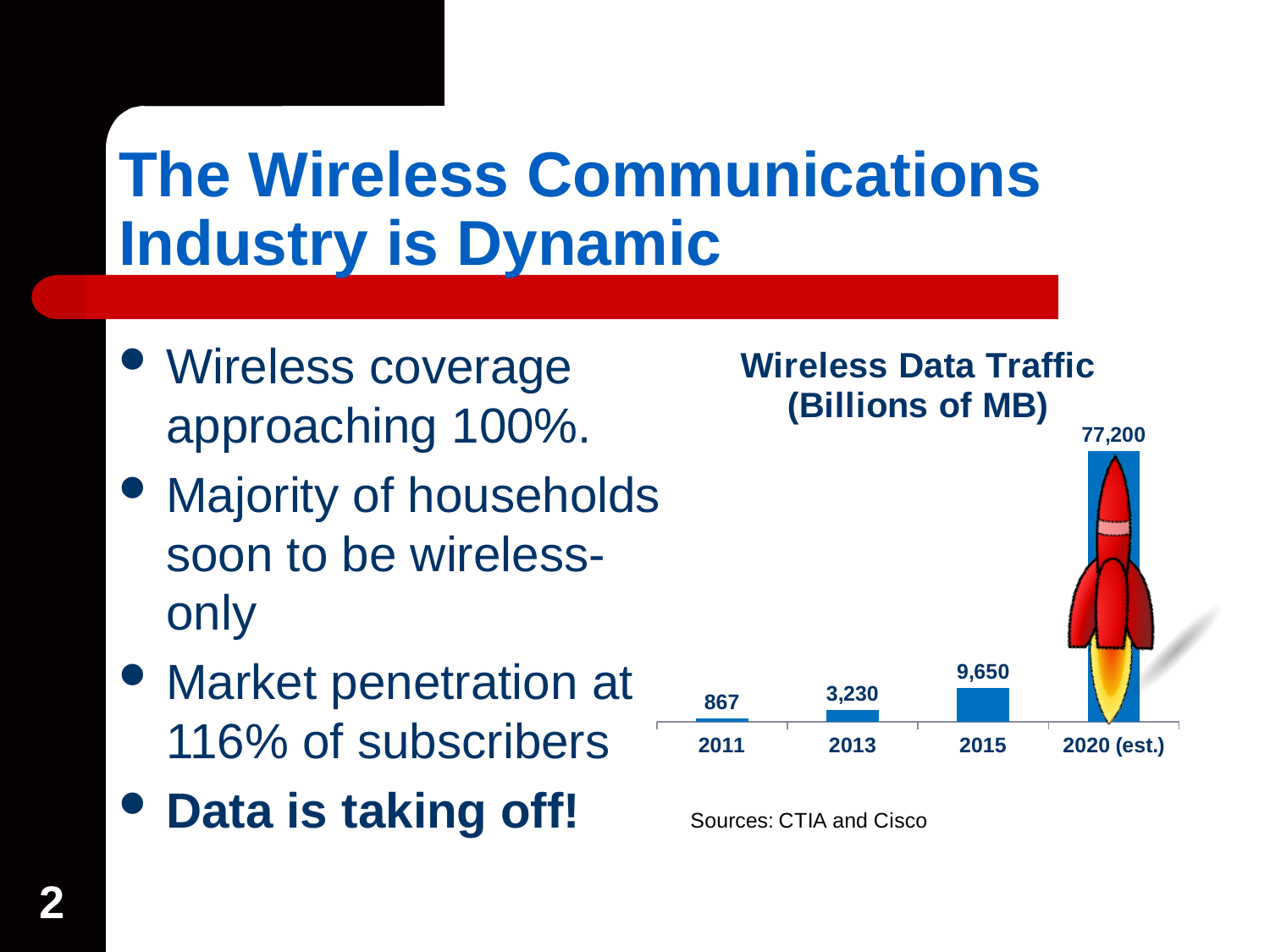
Which is larger, the wireless data traffic for 2013 or for 2015? 2015 What is the wireless data traffic value for 2011? 867 What is the wireless data traffic value for 2015? 9,650 What is the difference in wireless data traffic between 2015 and 2013? 6,420 Which year has the highest wireless data traffic? 2020 (est.) What is the estimated wireless data traffic value for 2020? 77,200 Which year has the lowest wireless data traffic? 2011 Do the wireless data traffic values rise or fall from 2011 to 2020? Rise What unit is given in the chart title for wireless data traffic? Billions of MB What kind of chart is used to show wireless data traffic? Bar chart How many years are shown on the x axis of the chart? 4 What is the wireless data traffic value for 2013? 3,230